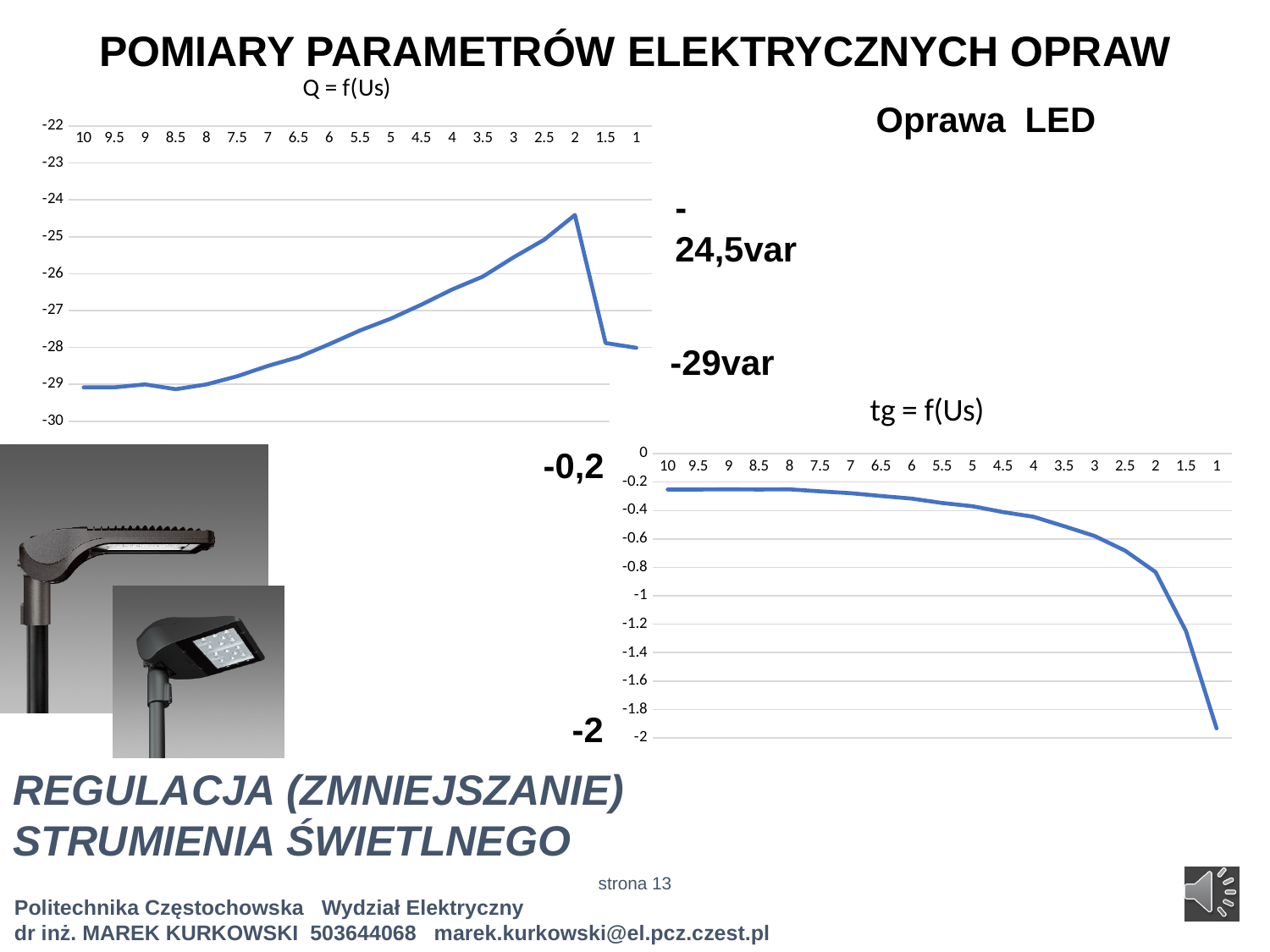
In the "Q = f(Us)" chart, is the value at x = 10 greater or less than -28? less In the "Q = f(Us)" chart, at which x-axis value does the line reach its highest point? 2 In the "tg = f(Us)" chart, is the value at x = 1 greater or less than -1.8? less In the "tg = f(Us)" chart, is the value at x = 10 greater or less than -0.4? greater In the "tg = f(Us)" chart, do the values rise or fall moving from left to right along the x axis? fall In the "tg = f(Us)" chart, how many x-axis categories are plotted? 19 What kind of chart is the "Q = f(Us)" chart? line chart In the "Q = f(Us)" chart, how many x-axis categories are plotted? 19 In the "tg = f(Us)" chart, at which x-axis value does the line reach its lowest point? 1 What kind of chart is the "tg = f(Us)" chart? line chart